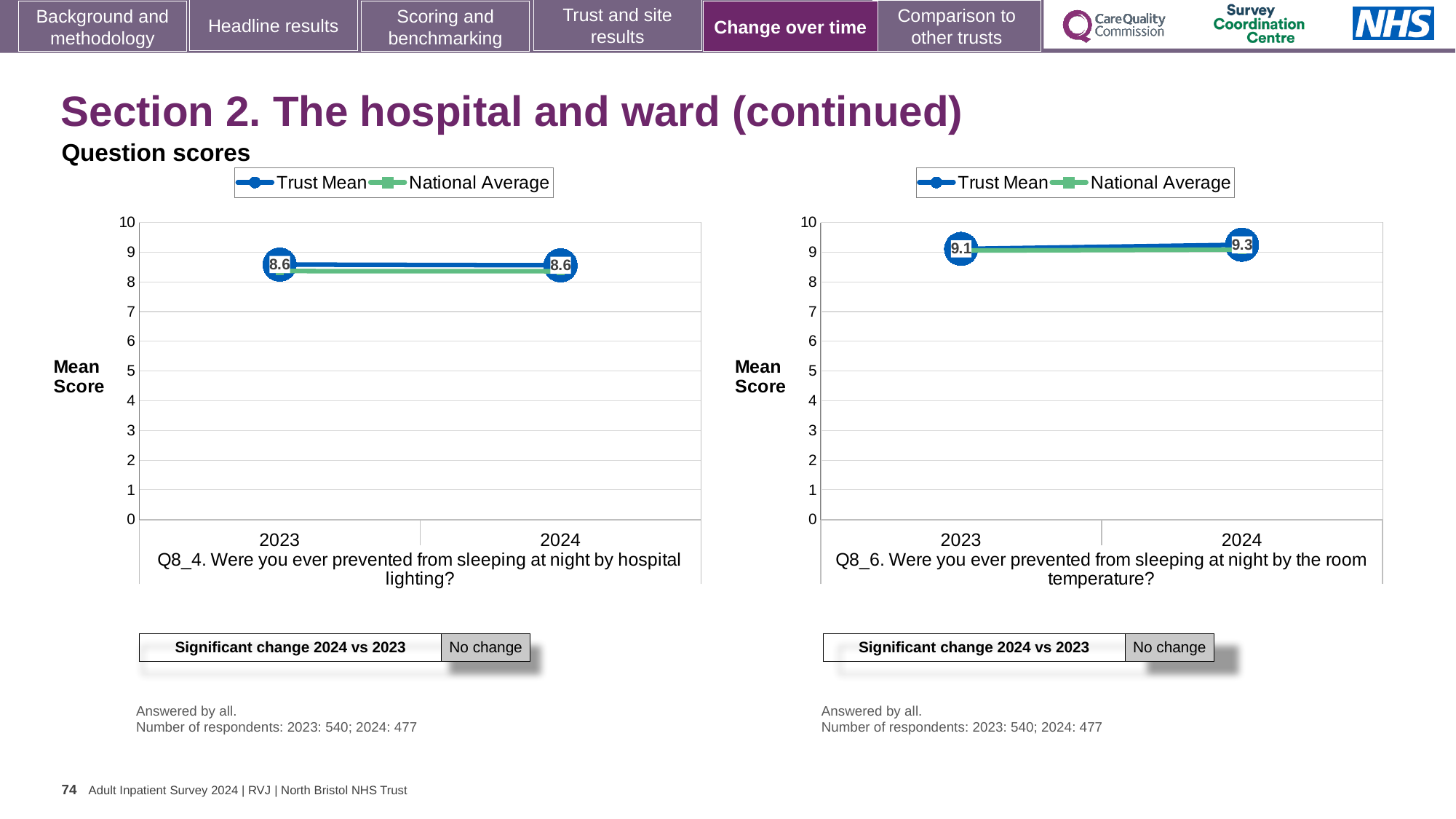
In the left chart (Q8_4, hospital lighting), is the National Average for 2024 greater or less than 8? greater In the left chart (Q8_4, hospital lighting), what is the Trust Mean score for 2024? 8.6 In the left chart (Q8_4, hospital lighting), what is the Trust Mean score for 2023? 8.6 In the right chart (Q8_6, room temperature), what is the Trust Mean score for 2024? 9.3 In the right chart (Q8_6, room temperature), which year has the higher Trust Mean, 2023 or 2024? 2024 In the right chart (Q8_6, room temperature), what is the Trust Mean score for 2023? 9.1 What kind of chart is the left chart (Q8_4, hospital lighting)? line chart In the right chart (Q8_6, room temperature), by how much did the Trust Mean change from 2023 to 2024? 0.2 In the right chart (Q8_6, room temperature), does the Trust Mean rise or fall from 2023 to 2024? rise What are the two series named in the legend of the right chart? Trust Mean and National Average How many series does the legend of the left chart list? 2 How many years are plotted on the x axis of the right chart? 2